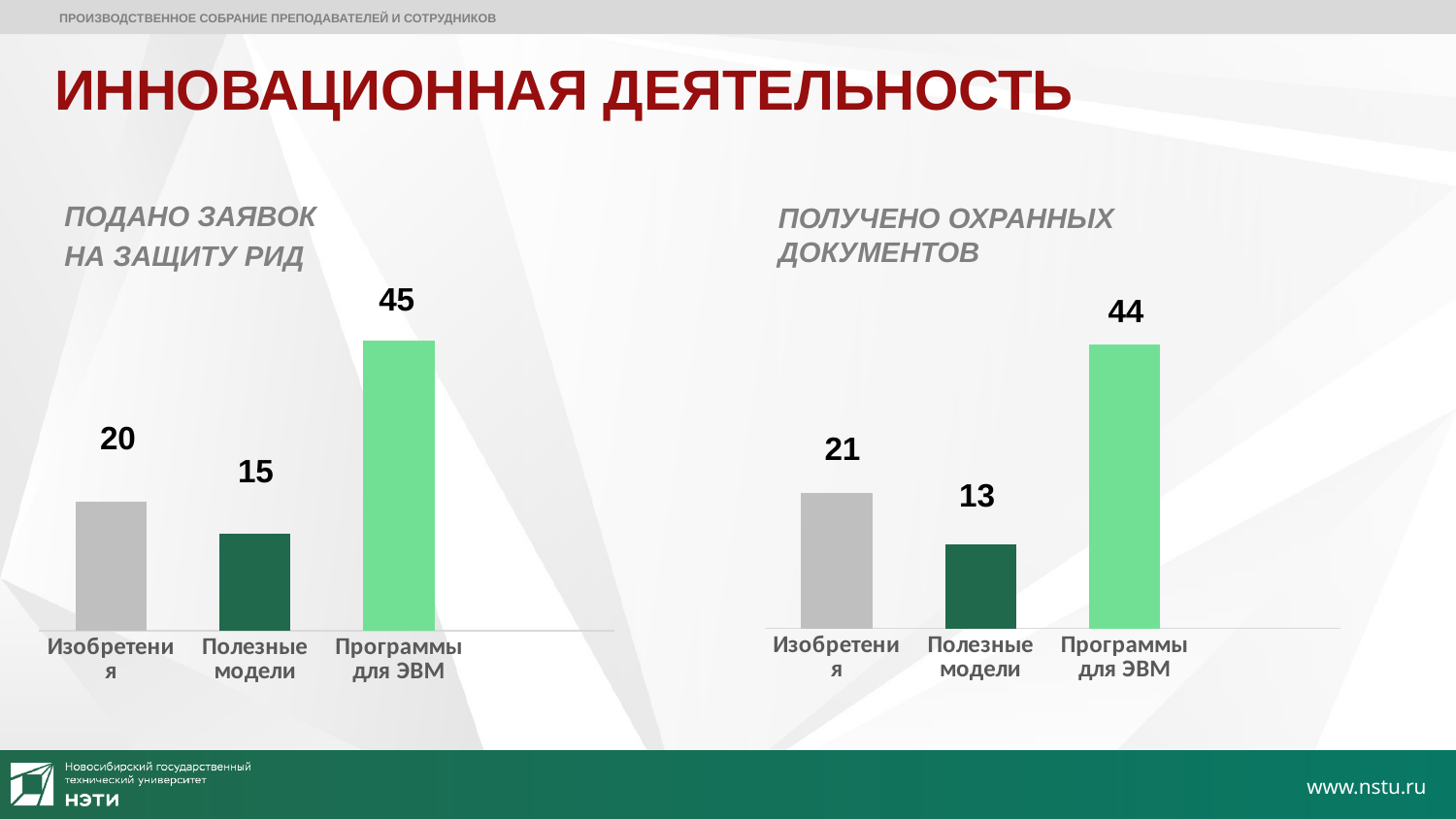
What kind of chart is the left chart (ПОДАНО ЗАЯВОК НА ЗАЩИТУ РИД)? Bar chart In the left chart (ПОДАНО ЗАЯВОК НА ЗАЩИТУ РИД), which category has the highest value? Программы для ЭВМ In the left chart (ПОДАНО ЗАЯВОК НА ЗАЩИТУ РИД), what is the difference between Программы для ЭВМ and Полезные модели? 30 What is the title of the right chart on the slide? ПОЛУЧЕНО ОХРАННЫХ ДОКУМЕНТОВ In the right chart (ПОЛУЧЕНО ОХРАННЫХ ДОКУМЕНТОВ), which category has the lowest value? Полезные модели In the left chart (ПОДАНО ЗАЯВОК НА ЗАЩИТУ РИД), which is larger: Изобретения or Полезные модели? Изобретения In the right chart (ПОЛУЧЕНО ОХРАННЫХ ДОКУМЕНТОВ), what is the difference between Программы для ЭВМ and Изобретения? 23 In the right chart (ПОЛУЧЕНО ОХРАННЫХ ДОКУМЕНТОВ), what is the value for Изобретения? 21 In the left chart (ПОДАНО ЗАЯВОК НА ЗАЩИТУ РИД), what is the value for Изобретения? 20 In the right chart (ПОЛУЧЕНО ОХРАННЫХ ДОКУМЕНТОВ), what is the value for Полезные модели? 13 How many categories does the right chart (ПОЛУЧЕНО ОХРАННЫХ ДОКУМЕНТОВ) show? 3 In the left chart (ПОДАНО ЗАЯВОК НА ЗАЩИТУ РИД), what is the value for Программы для ЭВМ? 45